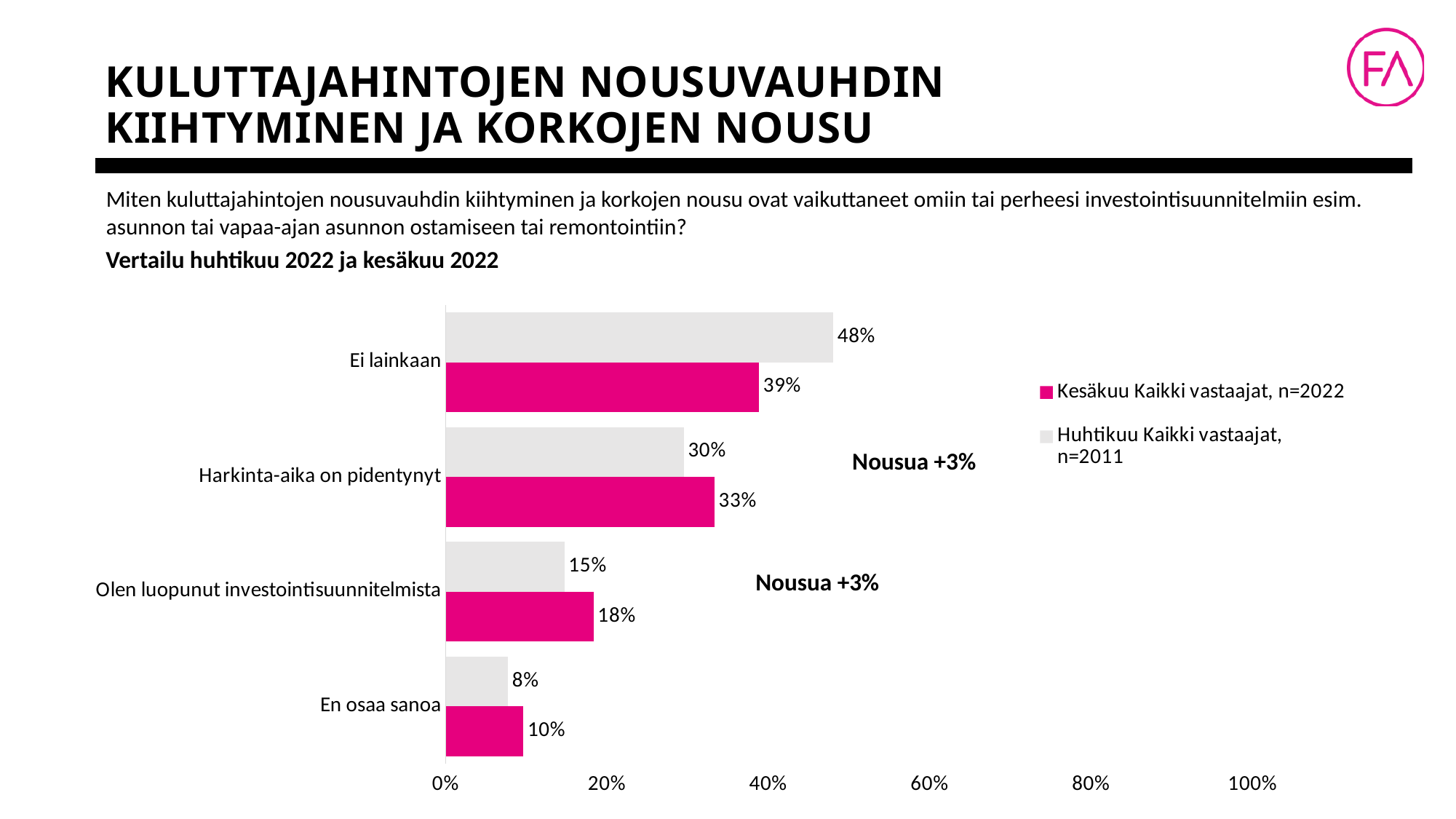
What is the value for "Olen luopunut investointisuunnitelmista" in the Kesäkuu series? 18% How many categories are shown on the chart? 4 What kind of chart is shown on the slide? Bar chart What is the value for "Harkinta-aika on pidentynyt" in the Huhtikuu Kaikki vastaajat, n=2011 series? 30% What is the difference between the Huhtikuu and Kesäkuu values for "Ei lainkaan"? 9% Which is larger for "Harkinta-aika on pidentynyt": the Kesäkuu value or the Huhtikuu value? Kesäkuu Is the Huhtikuu value for "Ei lainkaan" greater or less than 40%? greater Which category has the highest value in the Huhtikuu Kaikki vastaajat, n=2011 series? Ei lainkaan What is the value for "En osaa sanoa" in the Huhtikuu series? 8% Which category has the lowest value in the Kesäkuu Kaikki vastaajat, n=2022 series? En osaa sanoa How many series does the legend list? 2 What is the value for "Ei lainkaan" in the Kesäkuu Kaikki vastaajat, n=2022 series? 39%